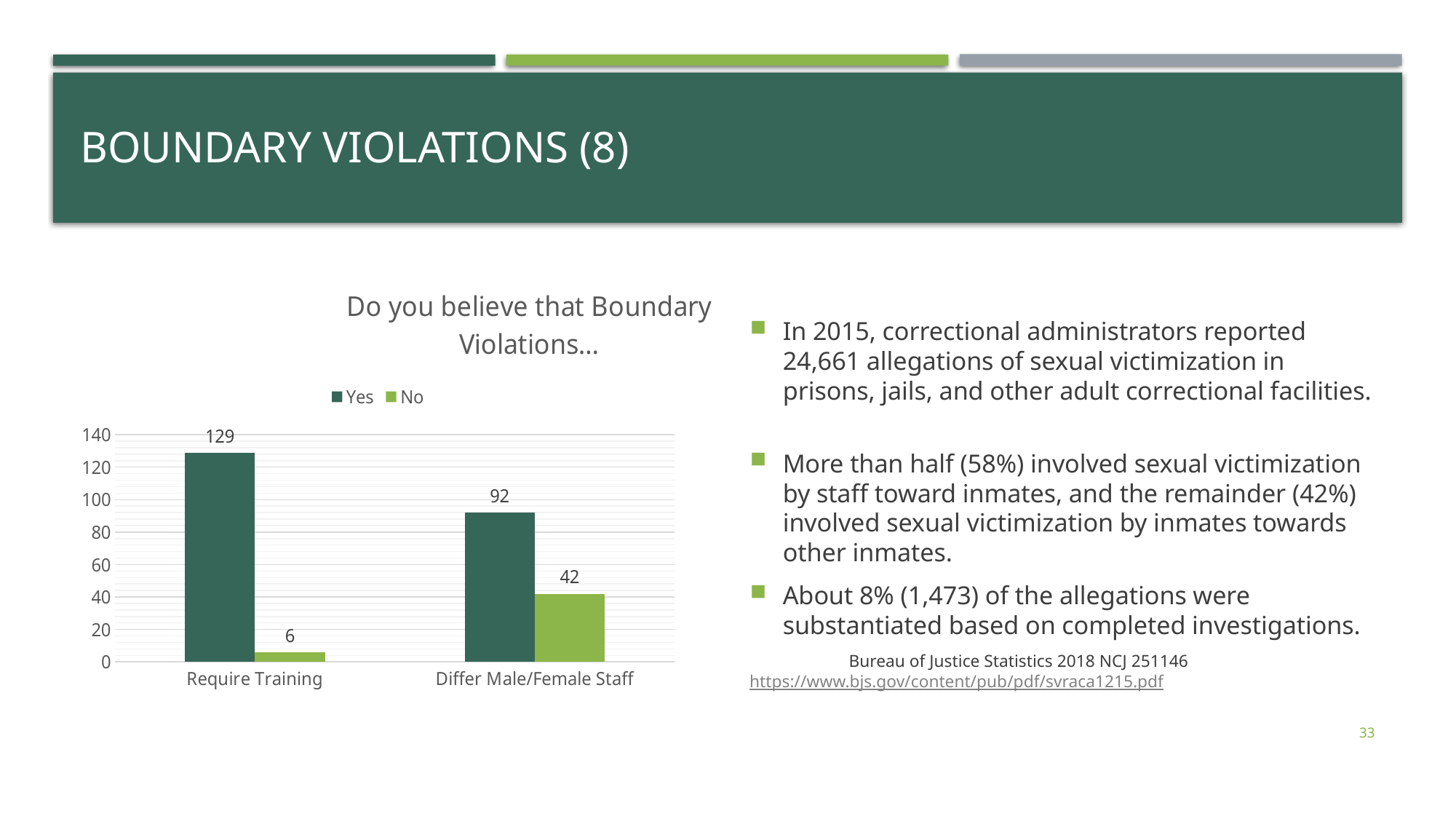
What is the difference between the 'Yes' and 'No' values for 'Require Training'? 123 Which is larger: the 'No' value for 'Differ Male/Female Staff' or the 'No' value for 'Require Training'? Differ Male/Female Staff What kind of chart is shown on the slide? Bar chart What is the 'No' value for 'Differ Male/Female Staff'? 42 Which category has the lowest 'No' value? Require Training How many categories are shown on the x axis? 2 What is the 'Yes' value for 'Require Training'? 129 What is the 'No' value for 'Require Training'? 6 What is the difference between the 'Yes' and 'No' values for 'Differ Male/Female Staff'? 50 Which category has the highest 'Yes' value? Require Training How many series does the legend list? 2 What is the 'Yes' value for 'Differ Male/Female Staff'? 92